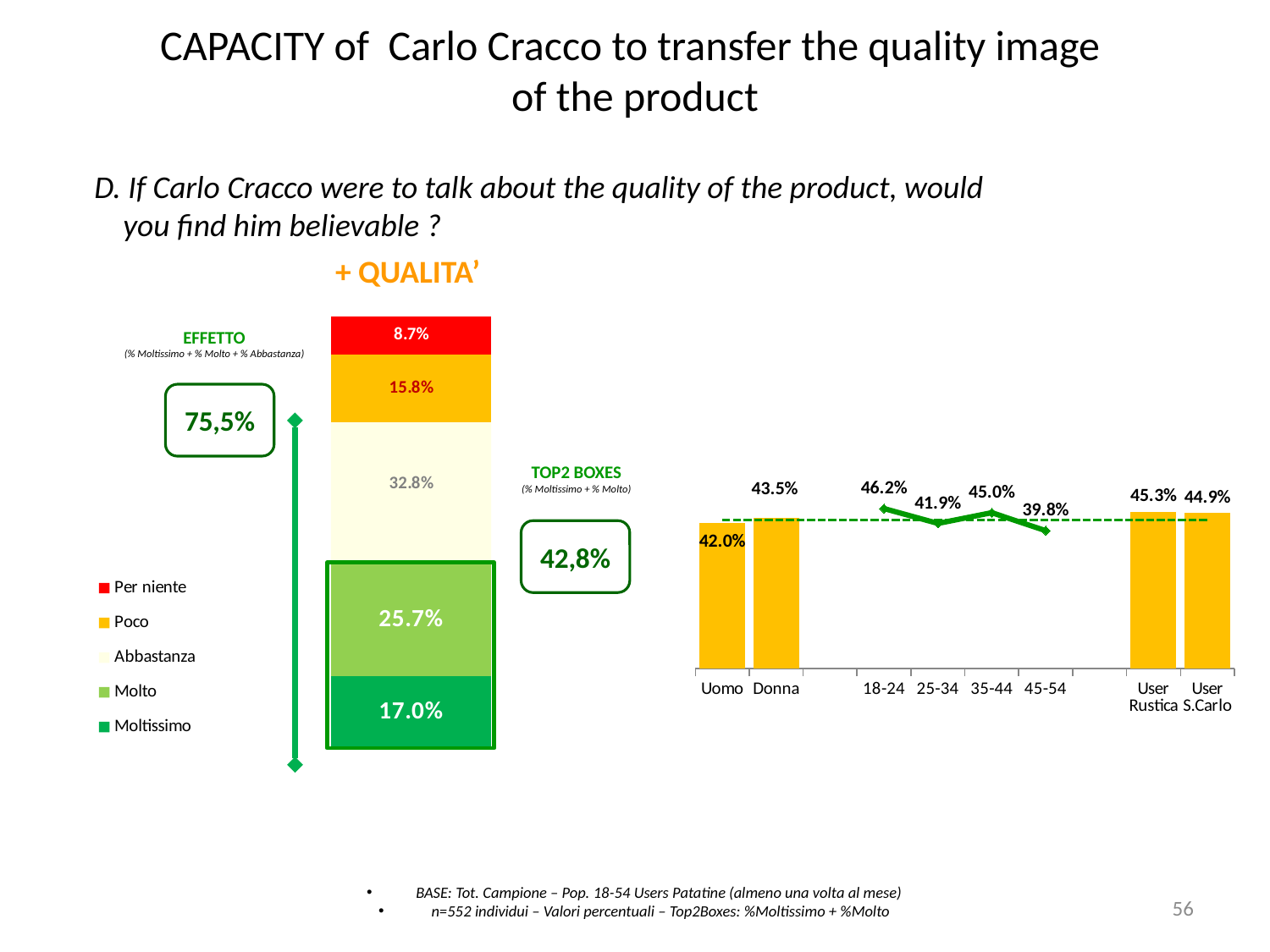
In the chart on the right, what value is shown for the 45-54 age group? 39.8% In the stacked bar chart on the left, what is the difference between the Poco and Per niente segments? 7.1% In the chart on the right, which is larger: the value for User Rustica or User S.Carlo? User Rustica In the chart on the right, what value is shown for Donna? 43.5% In the stacked bar chart on the left, which response category has the largest segment? Abbastanza In the stacked bar chart on the left, which response category has the smallest segment? Per niente In the chart on the right, which age group has the highest value? 18-24 In the stacked bar chart on the left, what percentage is shown for Abbastanza? 32.8% In the chart on the right, what is the difference between the values for Donna and Uomo? 1.5% In the stacked bar chart on the left, what percentage is shown for Moltissimo? 17.0% What kind of chart is the chart on the left of the slide? Stacked bar chart How many entries does the legend of the stacked bar chart on the left list? 5